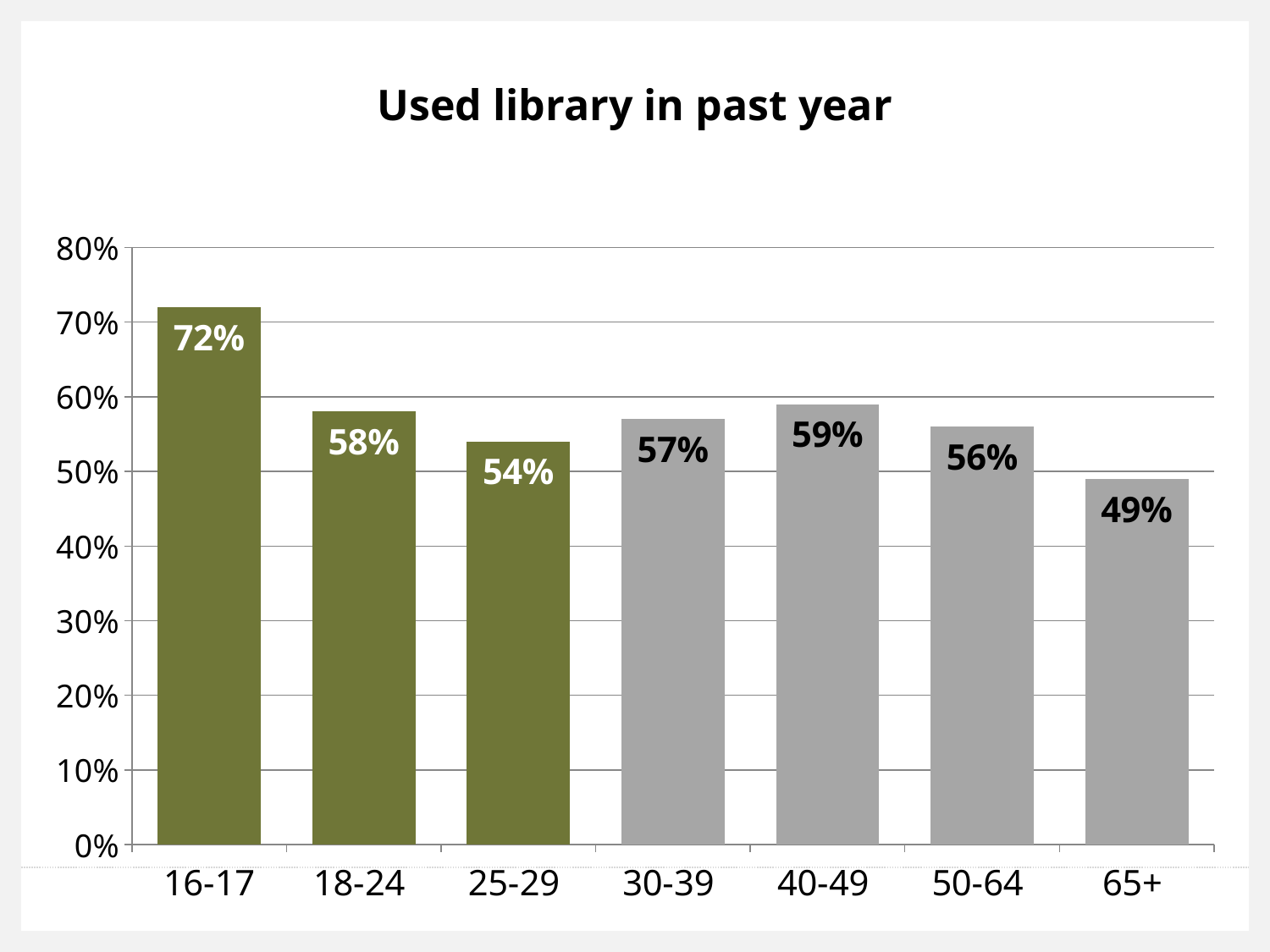
Which is larger, the value for 25-29 or the value for 40-49? 40-49 What is the difference between the values for the 16-17 and 65+ age groups? 23% What percentage of the 16-17 age group used the library in the past year? 72% What is the value for the 65+ age group? 49% Which age group has the highest share that used the library in the past year? 16-17 What is the value for the 40-49 age group? 59% What is the difference between the values for the 18-24 and 25-29 age groups? 4% Which age group has the lowest share that used the library in the past year? 65+ What kind of chart is shown on the slide? Bar chart How many age groups are shown on the chart? 7 What is the title of the chart? Used library in past year Is the value for the 16-17 age group greater or less than 70%? greater